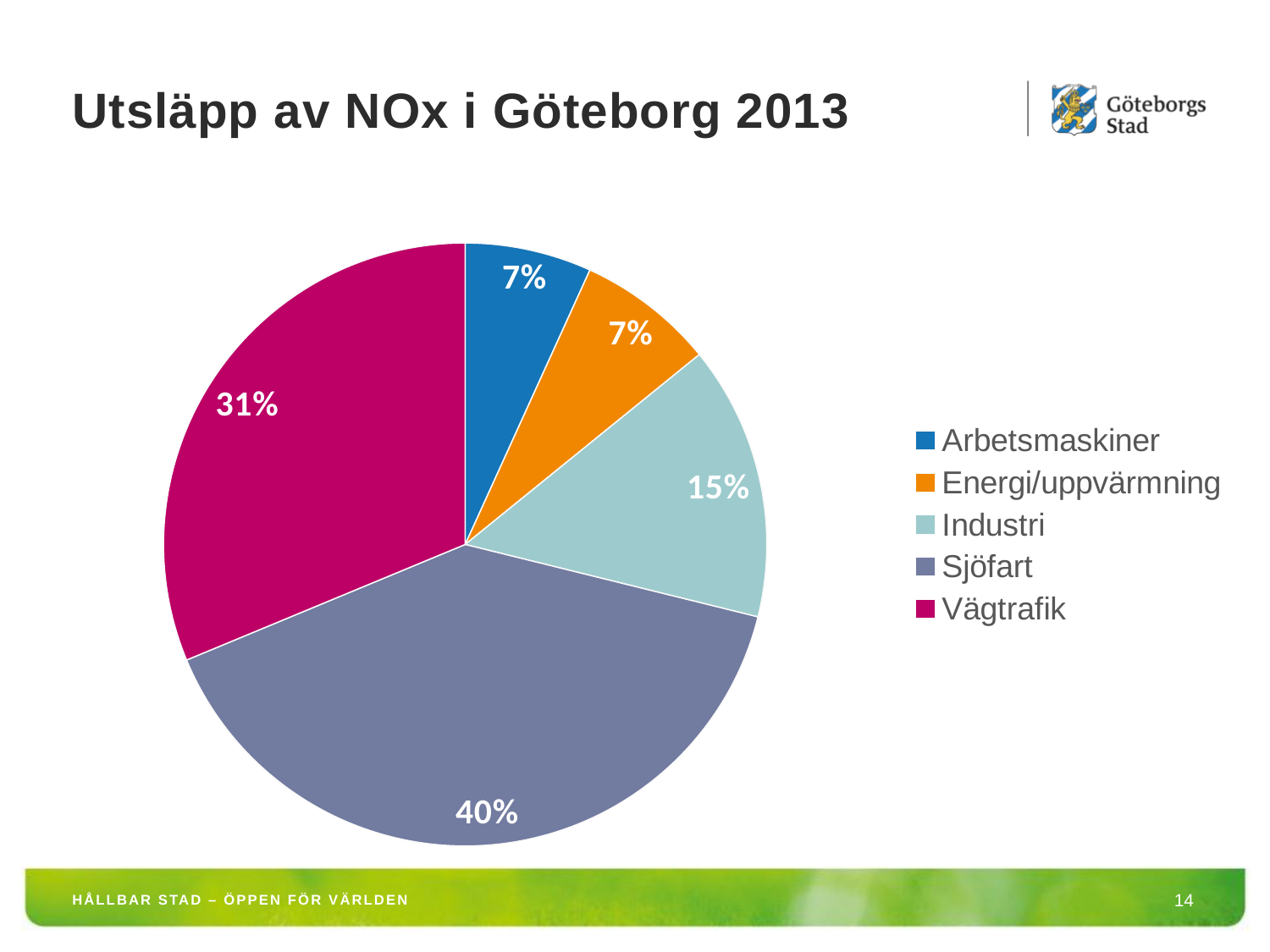
Which has a larger share, Industri or Vägtrafik? Vägtrafik What is the difference in percentage points between the Sjöfart and Vägtrafik shares? 9 What share of NOx emissions comes from Vägtrafik? 31% What share of NOx emissions comes from Energi/uppvärmning? 7% What is the title of the chart on the slide? Utsläpp av NOx i Göteborg 2013 What is the combined share of Sjöfart and Vägtrafik? 71% Which category has the largest share of NOx emissions? Sjöfart How many categories does the pie chart show? 5 What share of NOx emissions comes from Industri? 15% What kind of chart is shown on the slide? pie chart